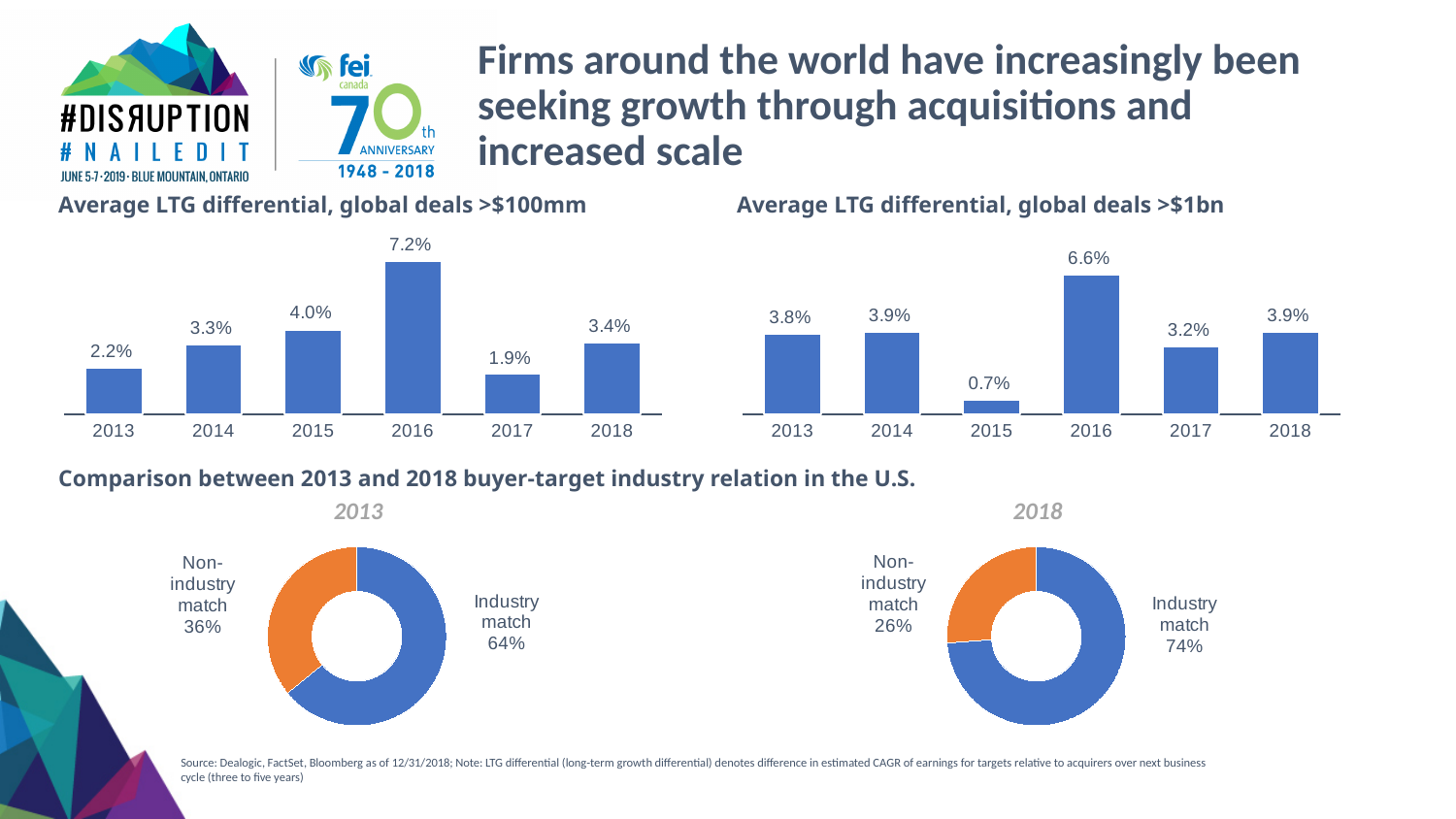
What is the difference between the 'Industry match' share in 2018 and in 2013? 10% In the 'Average LTG differential, global deals >$1bn' chart, is the value for 2013 or 2017 larger? 2013 In the 2018 buyer-target industry relation chart, what share is 'Non-industry match'? 26% In the 'Average LTG differential, global deals >$100mm' chart, what is the value for 2016? 7.2% What colour represents 'Non-industry match' in the 2013 and 2018 donut charts? Orange In the 2013 buyer-target industry relation chart, what share is 'Industry match'? 64% In the 'Average LTG differential, global deals >$100mm' chart, what is the difference between the 2016 and 2017 values? 5.3% In the 'Average LTG differential, global deals >$1bn' chart, which year has the highest value? 2016 In the 'Average LTG differential, global deals >$1bn' chart, what is the value for 2015? 0.7% In the 'Average LTG differential, global deals >$100mm' chart, which year has the lowest value? 2017 What type of chart is 'Average LTG differential, global deals >$100mm'? Bar chart How many years are shown in the 'Average LTG differential, global deals >$1bn' chart? 6